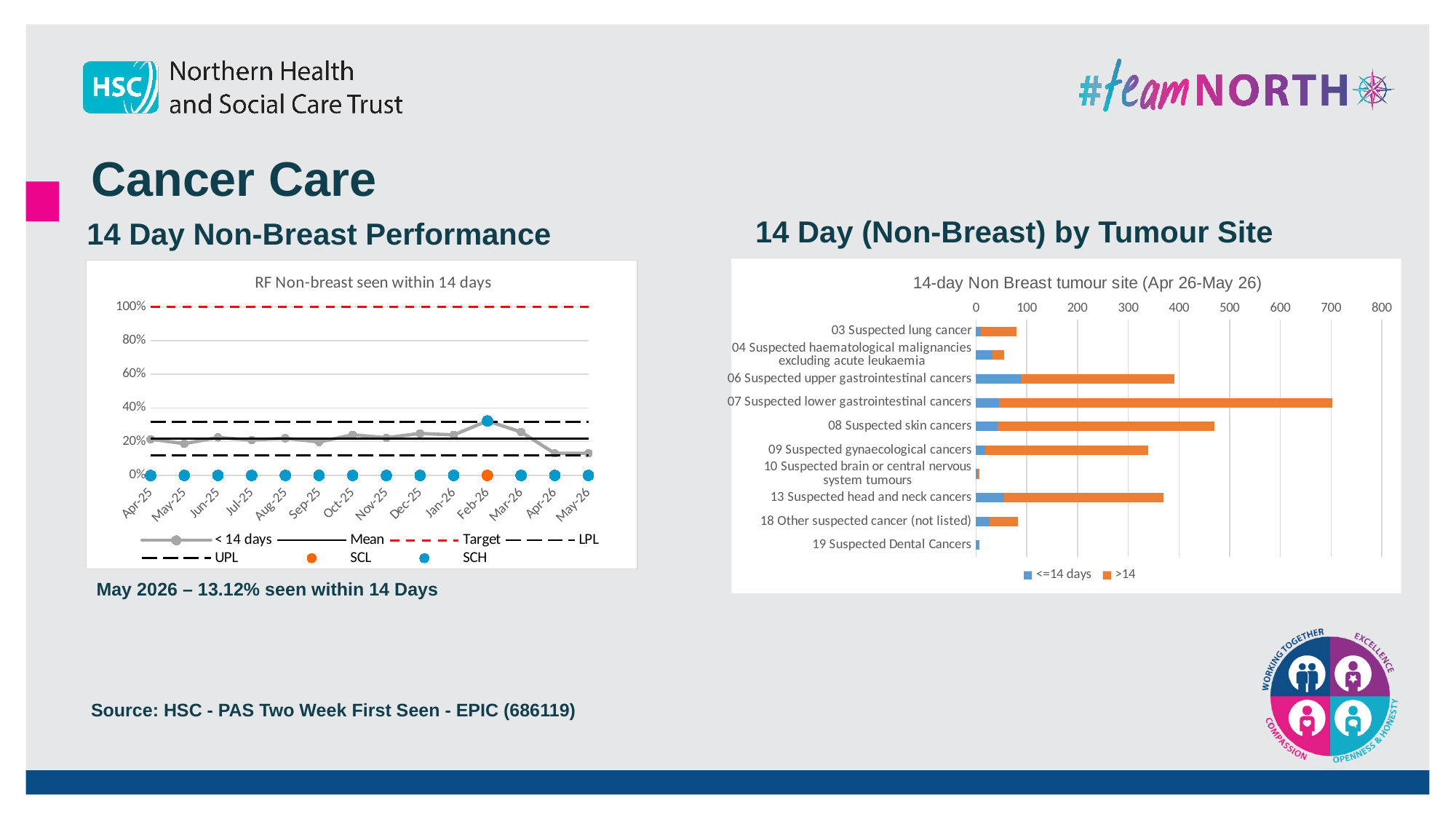
On the left chart 'RF Non-breast seen within 14 days', is the '< 14 days' value for Feb-26 greater or less than 20%? greater On the left chart titled 'RF Non-breast seen within 14 days', what percentage was seen within 14 days in May 2026? 13.12% On the left chart 'RF Non-breast seen within 14 days', what value does the red dashed Target line sit at? 100% What kind of chart is the right-hand chart '14-day Non Breast tumour site (Apr 26-May 26)'? Stacked bar chart On the left chart 'RF Non-breast seen within 14 days', does the '< 14 days' line rise or fall from Feb-26 to Apr-26? fall On the right chart '14-day Non Breast tumour site (Apr 26-May 26)', how many series does the legend list? 2 On the right chart '14-day Non Breast tumour site (Apr 26-May 26)', which tumour site has the longest bar? 07 Suspected lower gastrointestinal cancers On the left chart 'RF Non-breast seen within 14 days', how many entries does the legend list? 7 On the right chart '14-day Non Breast tumour site (Apr 26-May 26)', which has the longer bar: 08 Suspected skin cancers or 09 Suspected gynaecological cancers? 08 Suspected skin cancers On the left chart 'RF Non-breast seen within 14 days', how many months are plotted along the x axis? 14 On the right chart '14-day Non Breast tumour site (Apr 26-May 26)', how many tumour site categories are shown? 10 On the right chart '14-day Non Breast tumour site (Apr 26-May 26)', is the total bar for 08 Suspected skin cancers greater or less than 400? greater